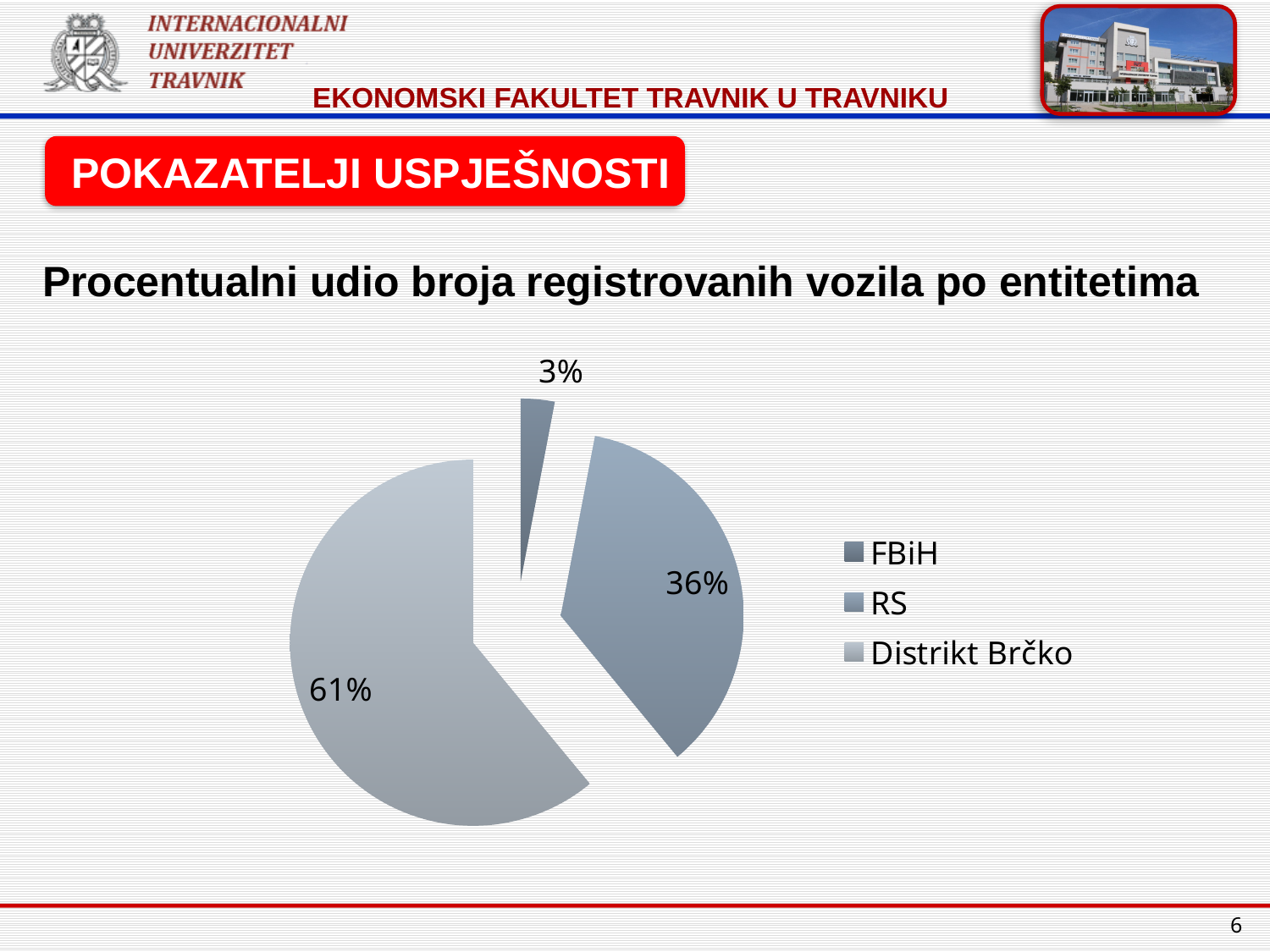
What are the legend entries of the pie chart? FBiH, RS, Distrikt Brčko What is the smallest share shown in the pie chart? 3% What kind of chart is shown on the slide? pie chart What is the largest share shown in the pie chart? 61% What share does the slice for FBiH have in the pie chart? 3% What share does the slice for Distrikt Brčko have in the pie chart? 61% How many slices does the pie chart have? 3 What is the title of the chart on the slide? Procentualni udio broja registrovanih vozila po entitetima How many entries does the legend of the pie chart list? 3 Which slice is larger in the pie chart, RS or FBiH? RS What is the difference between the 61% slice and the 36% slice in the pie chart? 25% What share does the slice for RS have in the pie chart? 36%